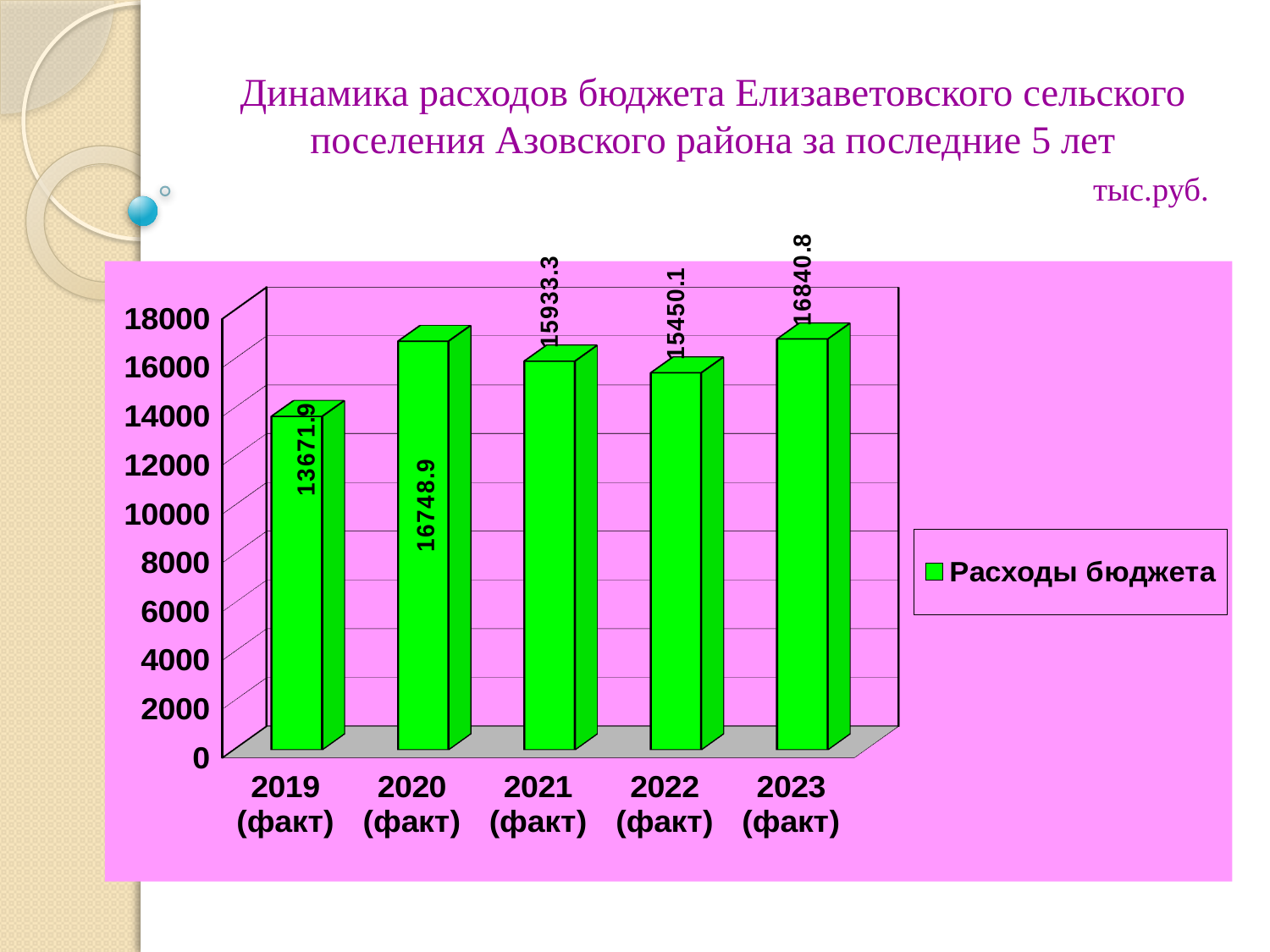
Is the value for 2019 (факт) greater or less than 14000? less What is the value for 2019 (факт)? 13671.9 Which is larger, the value for 2021 (факт) or 2022 (факт)? 2021 (факт) What is the value for 2022 (факт)? 15450.1 What is the difference between the values for 2020 (факт) and 2019 (факт)? 3077.0 How many series does the legend list? 1 What is the difference between the values for 2023 (факт) and 2022 (факт)? 1390.7 What kind of chart is shown on the slide? bar chart Which year has the highest budget expenditure? 2023 (факт) How many years are shown on the x axis? 5 What is the value for 2021 (факт)? 15933.3 Which year has the lowest budget expenditure? 2019 (факт)